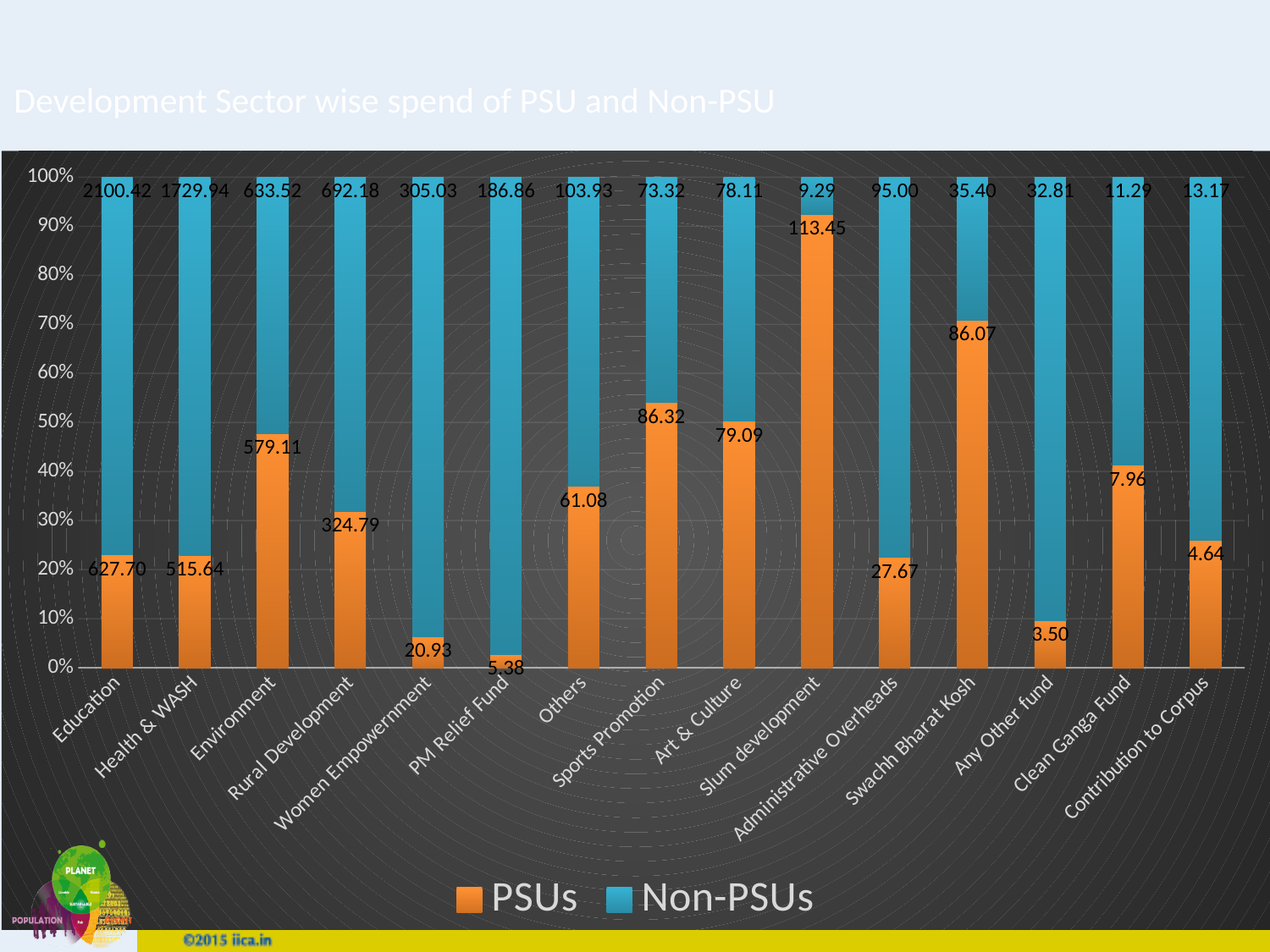
Which category has the highest Non-PSUs value? Education Is the PSUs share of the Slum development bar greater or less than 90%? greater What is the total of the PSUs and Non-PSUs values for Education? 2728.12 What is the Non-PSUs value for Health & WASH? 1729.94 How many series does the legend list? 2 What is the difference between the Non-PSUs and PSUs values for Environment? 54.41 How many categories are shown on the x axis? 15 What is the PSUs value for Education? 627.70 What kind of chart is shown on the slide? Stacked bar chart What is the PSUs value for Swachh Bharat Kosh? 86.07 Which category has the lowest PSUs value? Any Other fund Which is larger for Slum development, the PSUs value or the Non-PSUs value? PSUs